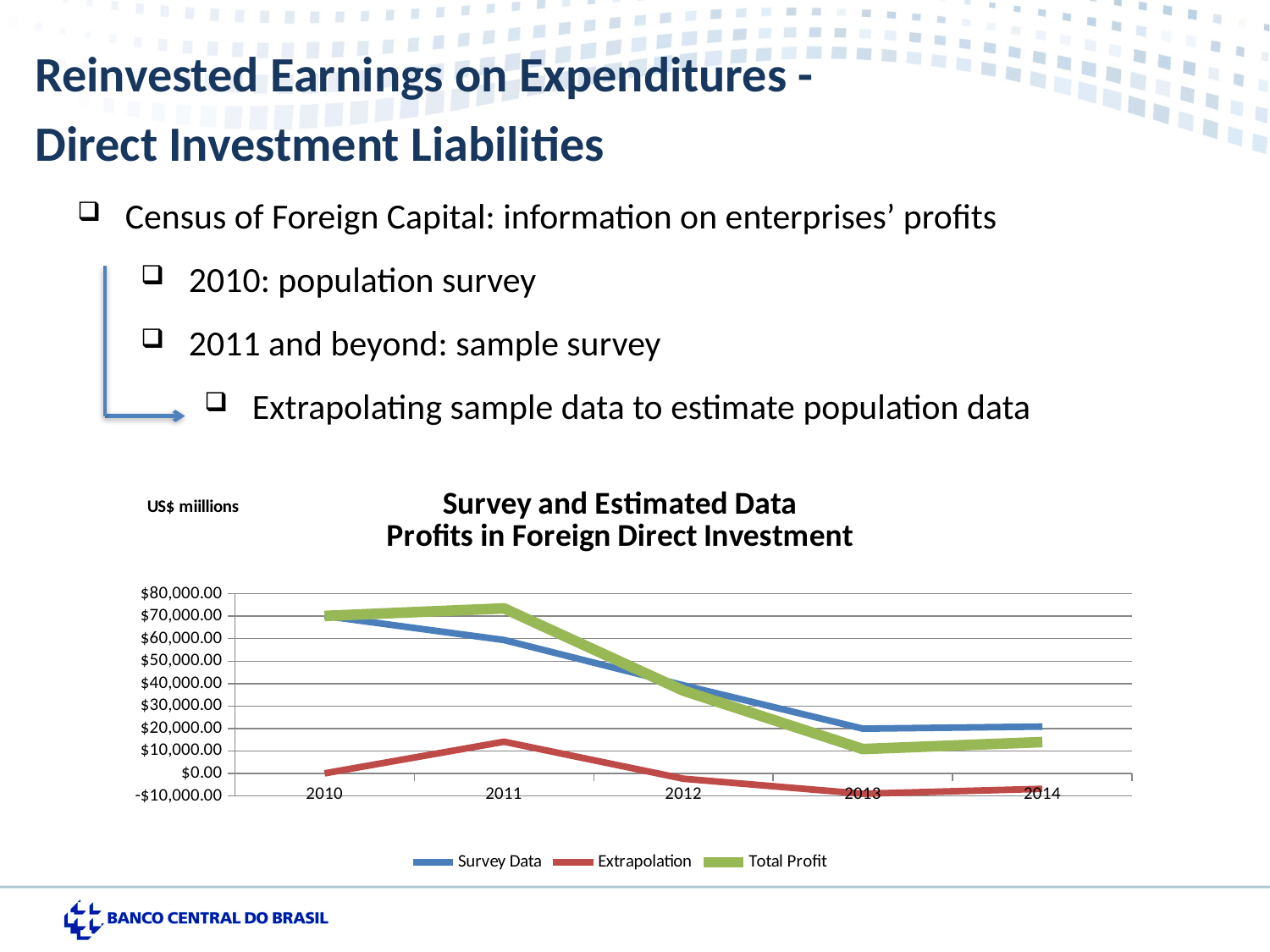
Is the Total Profit value for 2013 greater or less than $20,000.00? less In 2011, which series is larger: Total Profit or Survey Data? Total Profit Is the Extrapolation value for 2011 greater or less than $10,000.00? greater How many years are plotted along the x axis of the chart? 5 In which year is the Extrapolation series at its highest? 2011 What kind of chart is shown on the slide? line chart In 2014, which series is larger: Survey Data or Total Profit? Survey Data How many series does the chart legend list? 3 Does the Survey Data series rise or fall from 2010 to 2013? fall In which year is the Total Profit series at its lowest? 2013 Is the Survey Data value for 2012 greater or less than $30,000.00? greater What is the title of the chart? Survey and Estimated Data Profits in Foreign Direct Investment